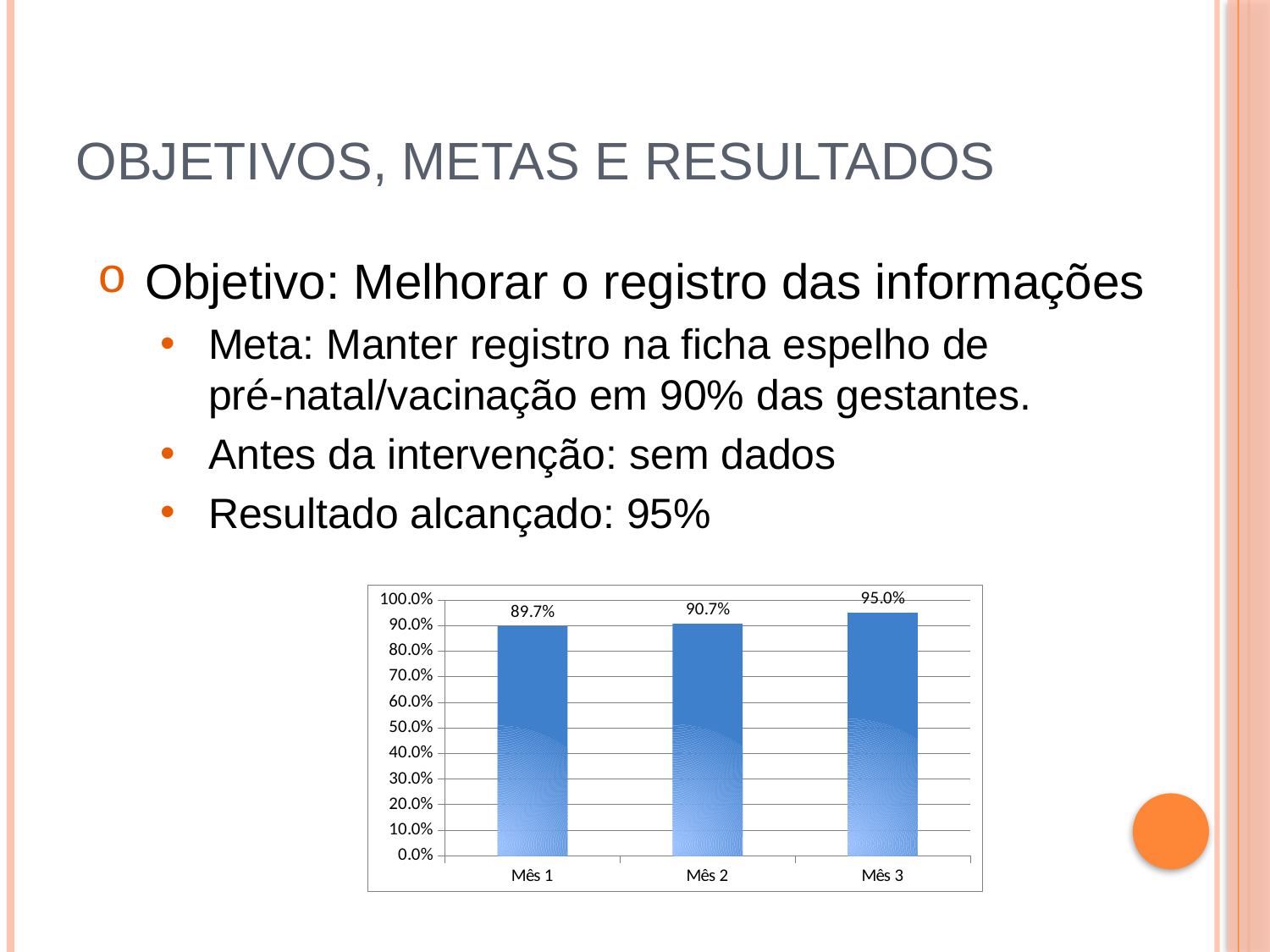
What is the value for Mês 2? 90.7% Which is larger, the value for Mês 3 or the value for Mês 2? Mês 3 What is the value for Mês 3? 95.0% What is the difference between the values for Mês 3 and Mês 1? 5.3% What kind of chart is shown on the slide? bar chart Which month has the lowest value? Mês 1 How many categories are shown on the x axis? 3 Which month has the highest value? Mês 3 What is the value for Mês 1? 89.7% Do the values rise or fall from Mês 1 to Mês 3? rise Is the value for Mês 1 greater or less than 90.0%? less What is the difference between the values for Mês 2 and Mês 1? 1.0%